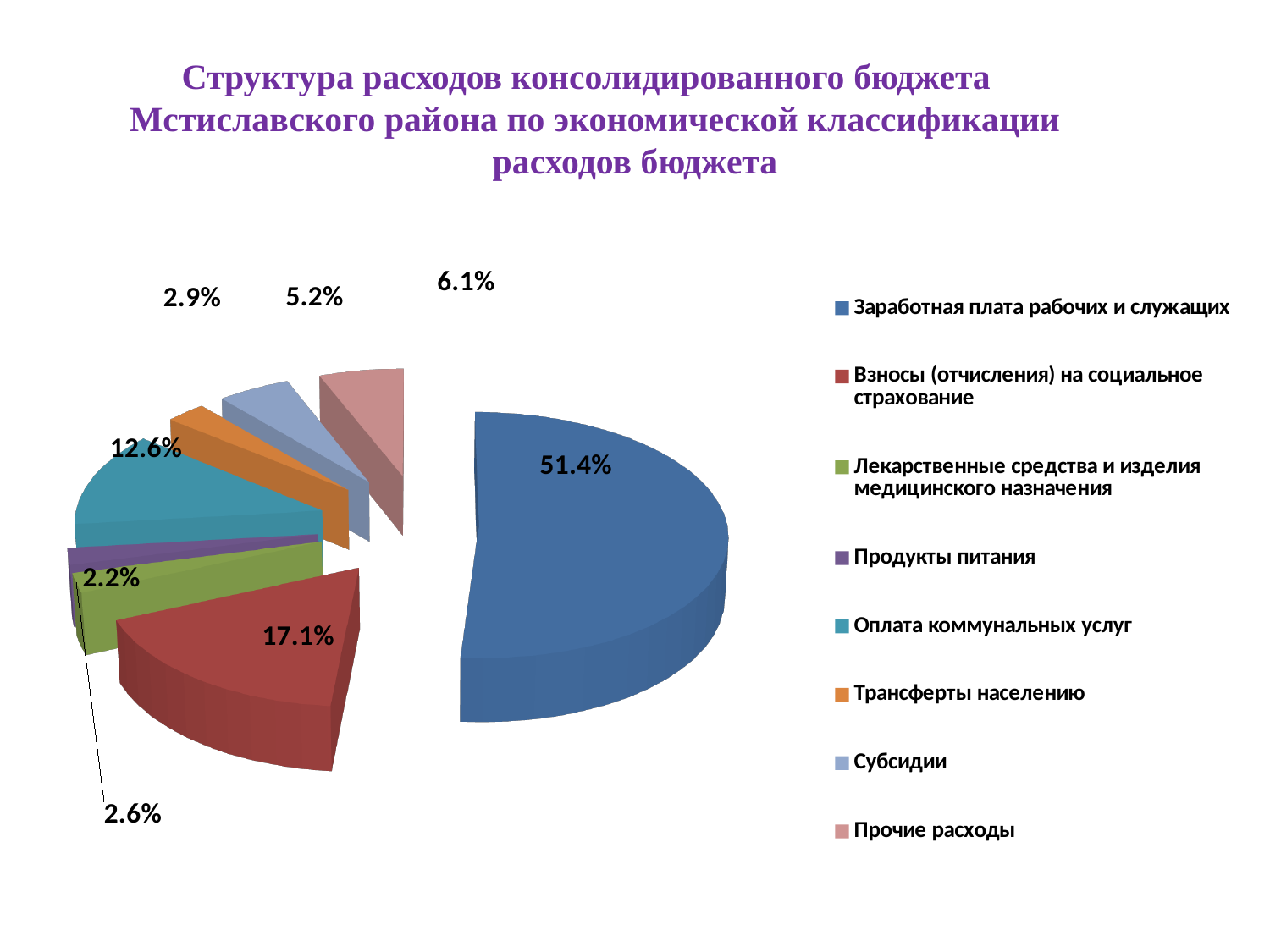
Which category has the largest share of the pie? Заработная плата рабочих и служащих Which is larger, the share of Субсидии or the share of Прочие расходы? Прочие расходы What is the difference between the shares of Заработная плата рабочих и служащих and Взносы (отчисления) на социальное страхование? 34.3% What share of expenditures is Субсидии? 5.2% What kind of chart is shown on the slide? pie chart What share of expenditures is Трансферты населению? 2.9% What share of expenditures is Прочие расходы? 6.1% Which category has the smallest share of the pie? Продукты питания How many categories does the legend list? 8 What share of expenditures is Оплата коммунальных услуг? 12.6% What share of expenditures is Взносы (отчисления) на социальное страхование? 17.1% What share of expenditures is Заработная плата рабочих и служащих? 51.4%